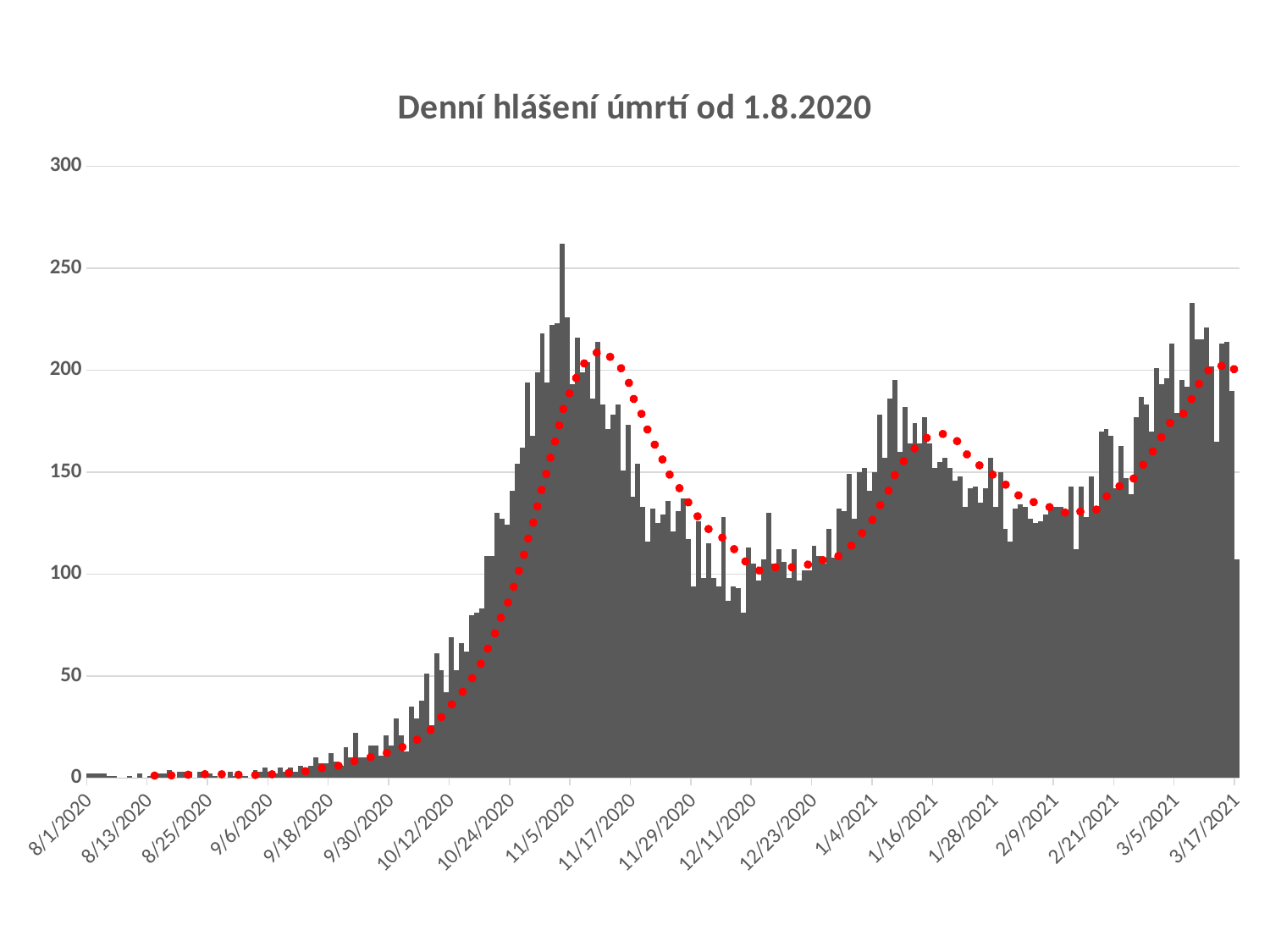
Is the value for the bar at 8/1/2020 greater or less than 50? less Is the value for the bar at 3/5/2021 greater or less than 150? greater Near which labelled x-axis date does the tallest bar occur? 11/5/2020 Is the value for the bar at 12/11/2020 greater or less than 150? less What is the title of the chart? Denní hlášení úmrtí od 1.8.2020 What is the highest value shown on the y axis? 300 Do the values rise or fall along the x axis between 8/1/2020 and 11/5/2020? rise Which is larger, the value at 11/5/2020 or the value at 12/11/2020? 11/5/2020 What kind of chart is shown on the slide? bar chart Do the values rise or fall along the x axis between 11/5/2020 and 12/11/2020? fall